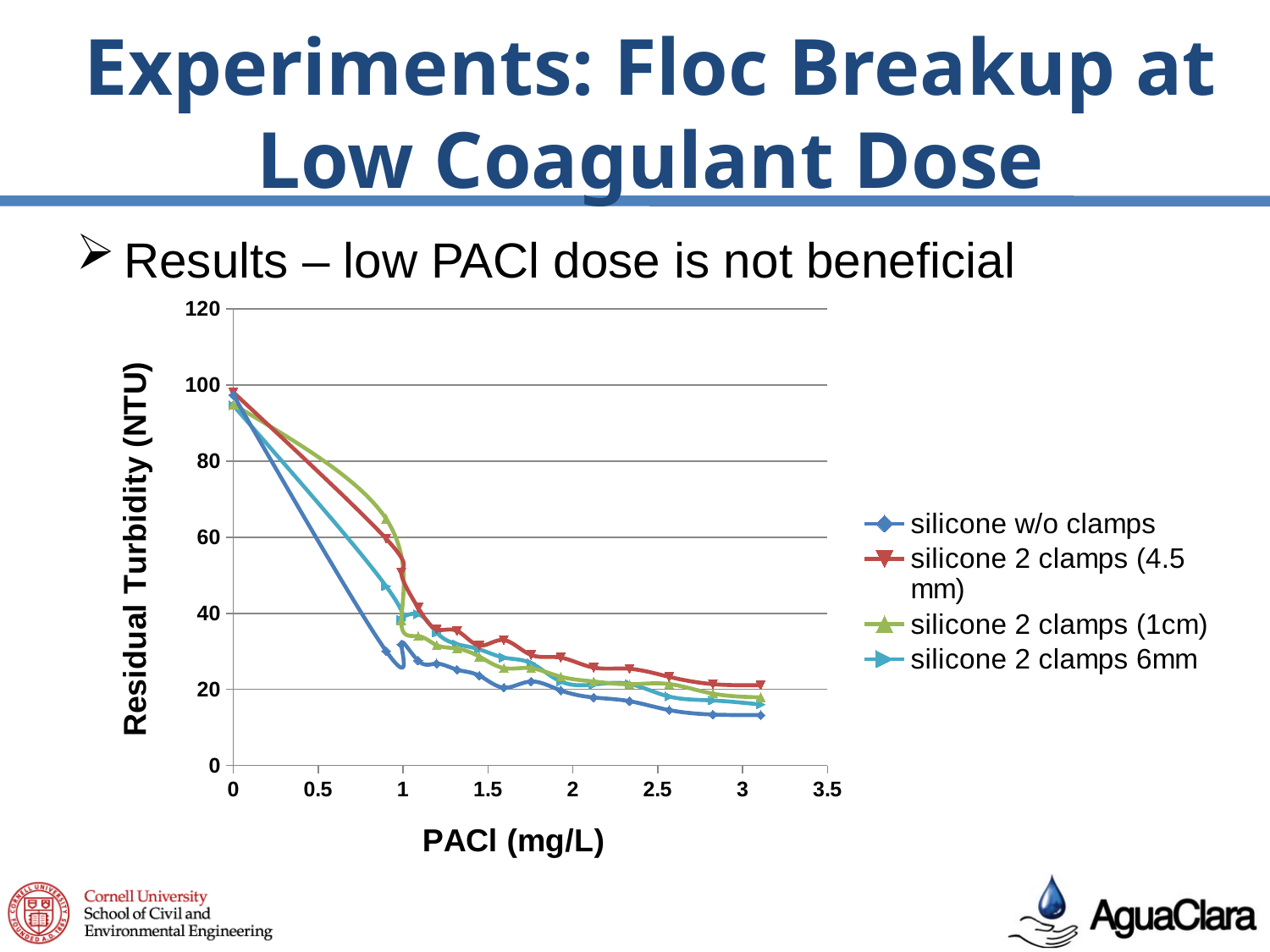
What kind of chart is shown on the slide? line chart Is the value for silicone w/o clamps at a PACl dose of 3 mg/L greater or less than 20? less Is the value for silicone 2 clamps (1cm) at a PACl dose of 0 mg/L greater or less than 100? less Which series has the lowest residual turbidity at a PACl dose of 3 mg/L? silicone w/o clamps Do the residual turbidity values rise or fall as the PACl dose increases? fall Is the value for silicone 2 clamps (4.5 mm) at a PACl dose of 0.5 mg/L greater or less than 60? greater At a PACl dose of 0.5 mg/L, which series has the higher residual turbidity: silicone w/o clamps or silicone 2 clamps (4.5 mm)? silicone 2 clamps (4.5 mm) Which series has the highest residual turbidity at a PACl dose of 3 mg/L? silicone 2 clamps (4.5 mm) What is the label of the x axis? PACl (mg/L) What is the label of the y axis? Residual Turbidity (NTU) How many series does the legend list? 4